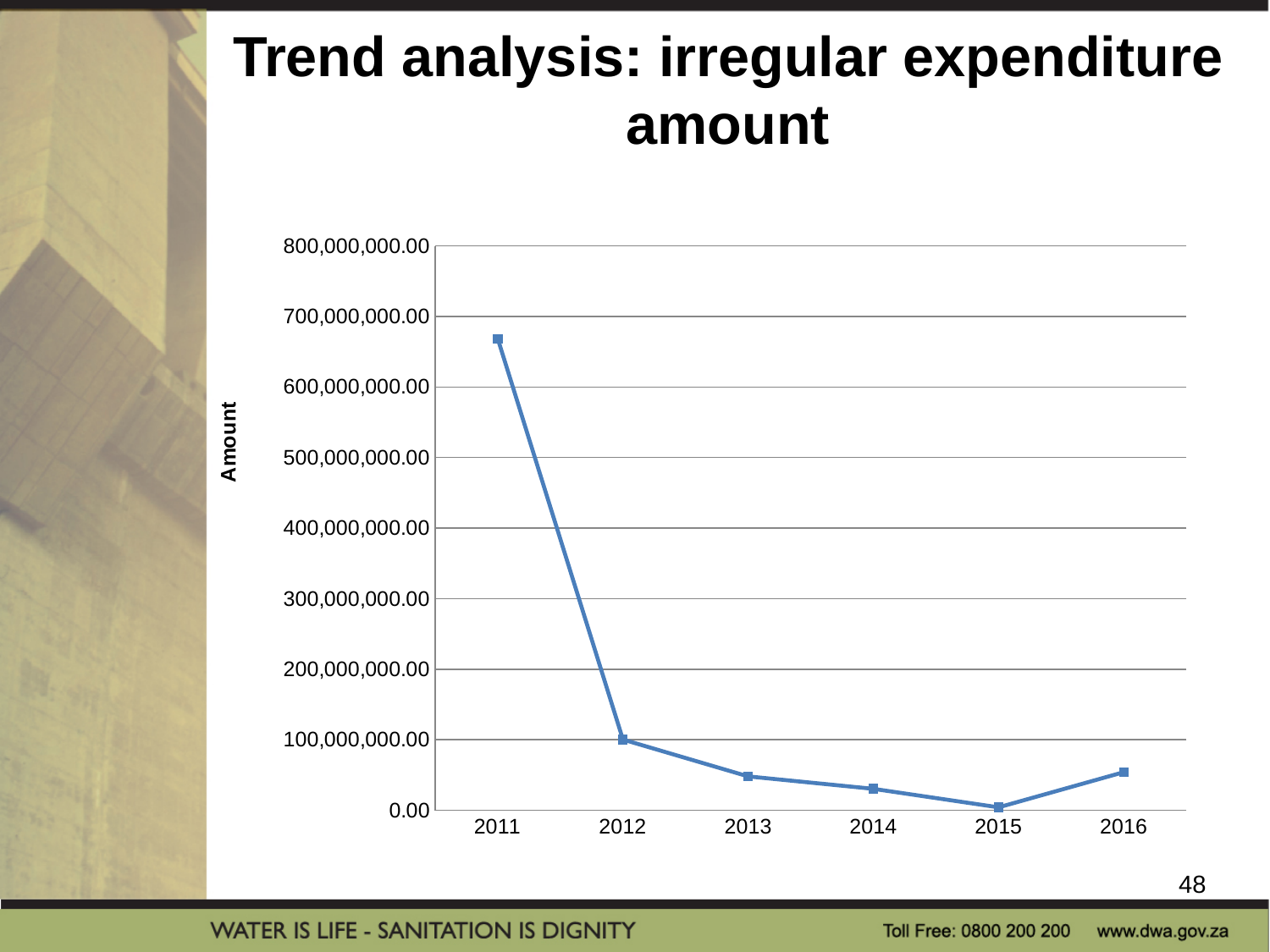
Which year has the larger irregular expenditure amount, 2011 or 2012? 2011 Is the value for 2011 greater or less than 600,000,000.00? greater How many years are plotted on the x axis of the chart? 6 Which year has the lowest irregular expenditure amount? 2015 Is the value for 2016 greater or less than 100,000,000.00? less Which year has the larger irregular expenditure amount, 2015 or 2016? 2016 What is the label on the vertical axis of the chart? Amount Is the value for 2013 greater or less than 100,000,000.00? less Does the irregular expenditure amount rise or fall from 2011 to 2015? fall Which year has the highest irregular expenditure amount? 2011 What kind of chart is shown on the slide? line chart